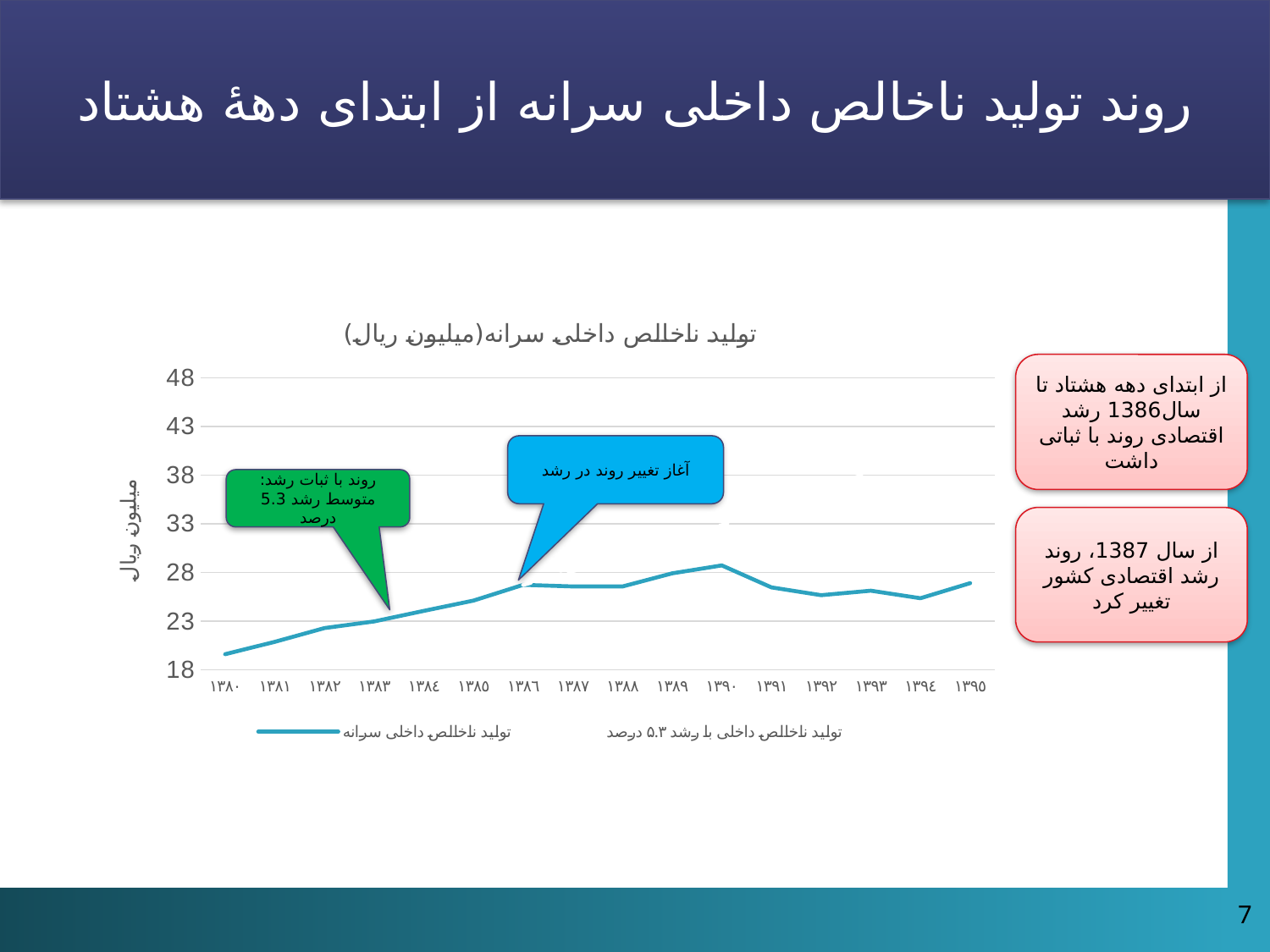
Is the value for ۱۳۹۵ greater or less than 28? less How many series does the chart legend list? 2 Which is larger, the value for ۱۳۸۰ or the value for ۱۳۹۰? ۱۳۹۰ How many years are plotted along the x axis of the chart? 16 Is the value for ۱۳۹۰ greater or less than 23? greater What kind of chart is shown on the slide? Line chart Does the plotted line rise or fall from ۱۳۸۰ to ۱۳۹۰? rise Which year has the highest value on the plotted line? ۱۳۹۰ Which year has the lowest value on the plotted line? ۱۳۸۰ What is the title of the chart? تولید ناخالص داخلی سرانه(میلیون ریال) Is the value for ۱۳۸۰ greater or less than 23? less What is the label on the vertical axis of the chart? میلیون ریال